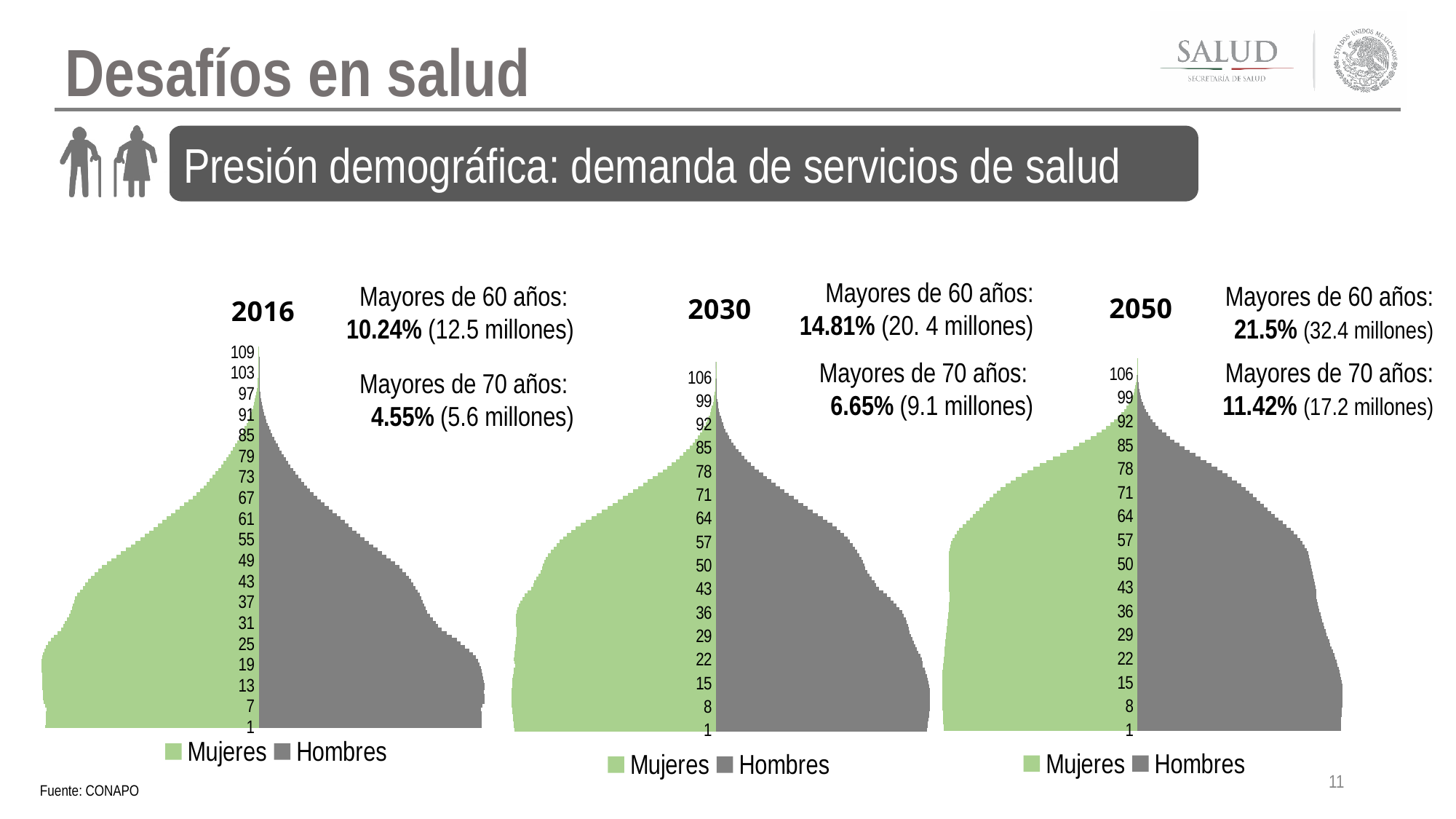
In the 2016 chart, which colour represents Hombres? grey What are the two series named in the legend of the 2050 chart? Mujeres and Hombres What is the lowest age tick shown on the axis of the 2050 chart? 1 What is the highest age tick shown on the axis of the 2016 chart? 109 What kind of chart is the 2016 chart? bar chart According to the annotation next to the 2016 chart, what percentage of the population is over 60 years old? 10.24% What is the highest age tick shown on the axis of the 2030 chart? 106 In the 2050 chart, do the bar lengths rise or fall as age increases from 57 to 99? fall According to the annotation next to the 2050 chart, what percentage of the population is over 60 years old? 21.5% How many series does the legend of the 2030 chart list? 2 How many population pyramid charts are shown on the slide? 3 According to the annotation next to the 2030 chart, how many millions of people are over 70 years old? 9.1 millones